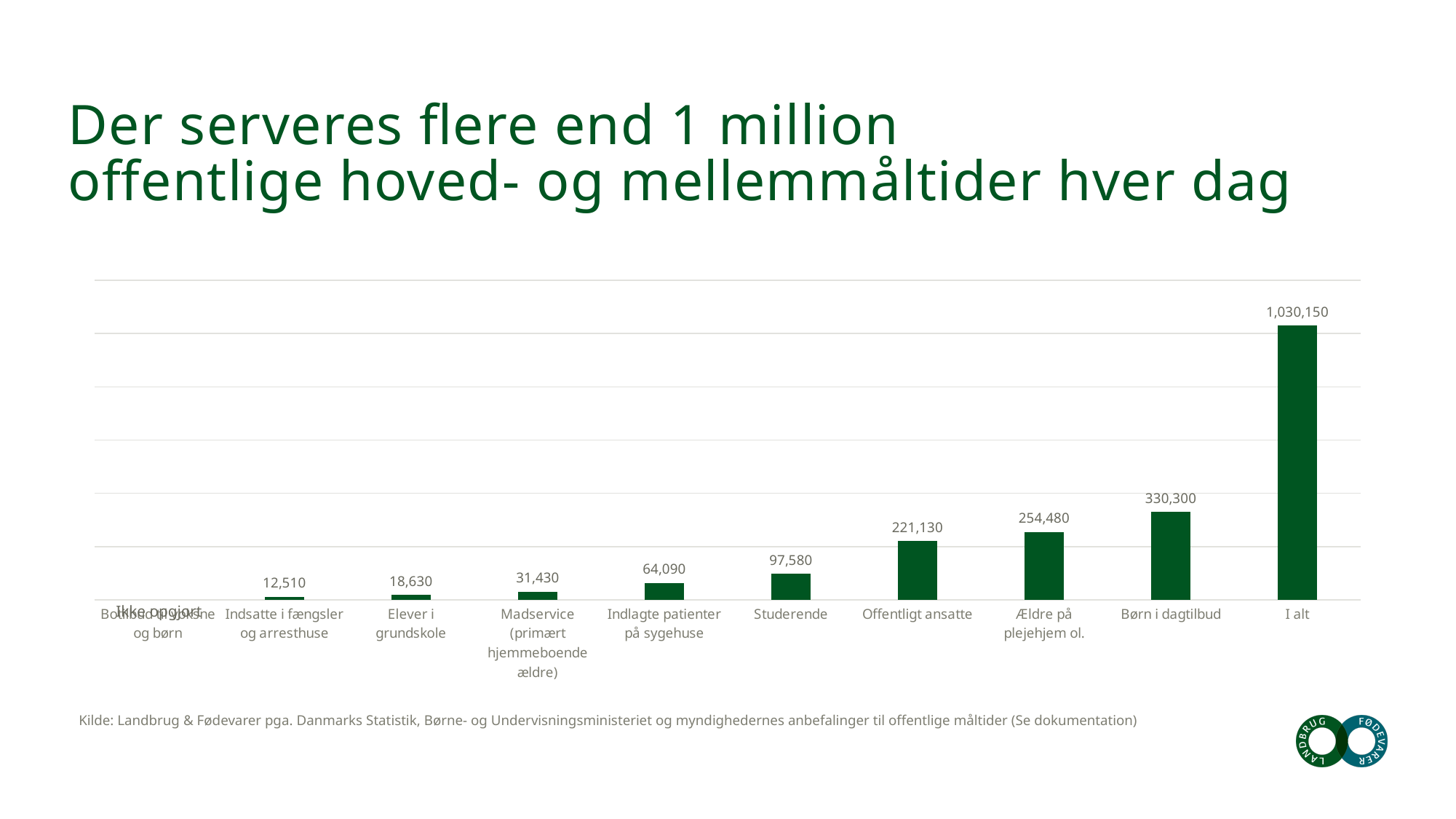
What is the value of the I alt bar? 1,030,150 What value is shown for Ældre på plejehjem ol.? 254,480 Which is larger, Indlagte patienter på sygehuse or Madservice (primært hjemmeboende ældre)? Indlagte patienter på sygehuse Which category with a printed value has the lowest value? Indsatte i fængsler og arresthuse What is the difference between Offentligt ansatte and Studerende? 123,550 What value is shown for Indsatte i fængsler og arresthuse? 12,510 Excluding the I alt total, which category has the highest value? Børn i dagtilbud What is the difference between Børn i dagtilbud and Ældre på plejehjem ol.? 75,820 What value is shown for Børn i dagtilbud? 330,300 Which category is marked as 'Ikke opgjort' (not calculated) instead of having a bar? Botilbud til voksne og børn What kind of chart is shown on the slide? Bar chart What value is shown for Studerende? 97,580